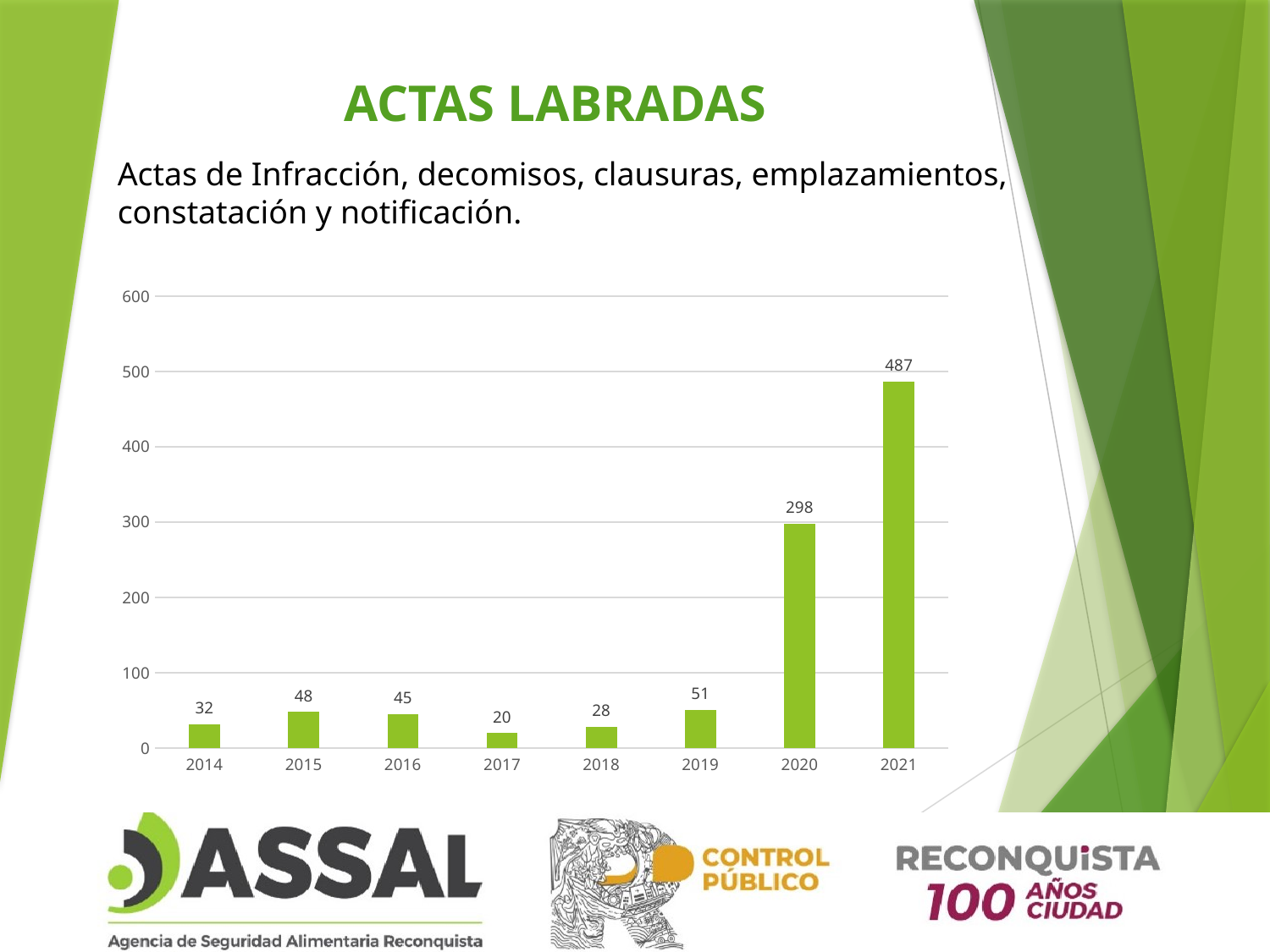
Which year has the highest value? 2021 Which year has the lowest value? 2017 What kind of chart is shown on the slide? Bar chart What is the value for 2020? 298 Is the value for 2020 greater or less than 200? greater Which is larger, the value for 2015 or the value for 2016? 2015 Do the values rise or fall from 2019 to 2021? Rise What is the value for 2021? 487 How many years are shown on the x axis? 8 What is the value for 2017? 20 What is the difference between the values for 2021 and 2020? 189 What is the title of the slide containing the chart? ACTAS LABRADAS